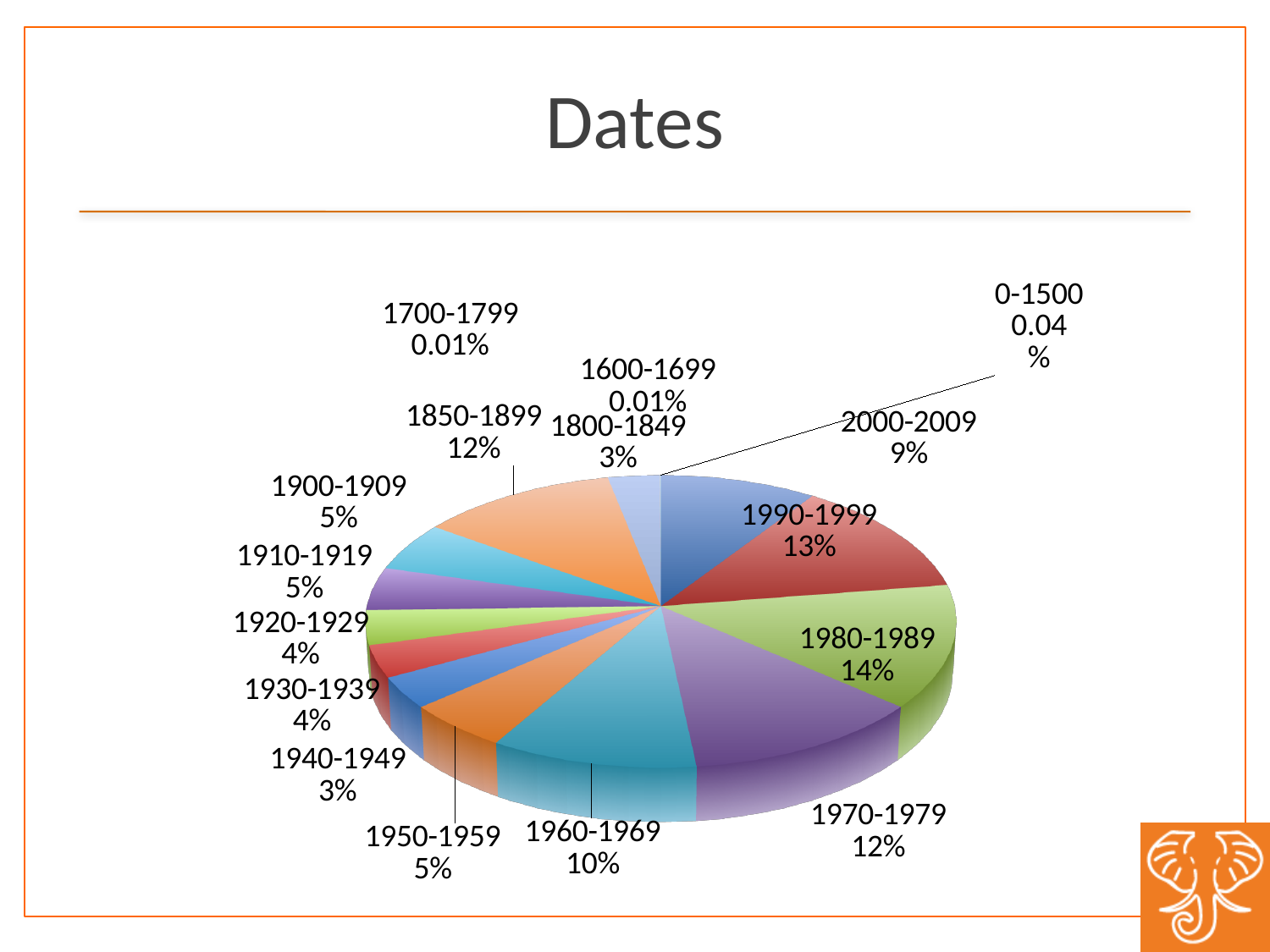
What is the title of the chart? Dates What percentage does the 1980-1989 slice represent? 14% Which has a larger share, 1990-1999 or 1970-1979? 1990-1999 What percentage is shown for 0-1500? 0.04% What percentage is shown for 1960-1969? 10% What percentage is shown for 1850-1899? 12% How many date ranges are shown in the pie chart? 16 What kind of chart is shown on the slide? pie chart What is the difference in percentage points between 1980-1989 and 1990-1999? 1% What is the difference in percentage points between 1850-1899 and 1800-1849? 9% Which date range has the largest share of the pie? 1980-1989 Which has a larger share, 2000-2009 or 1960-1969? 1960-1969